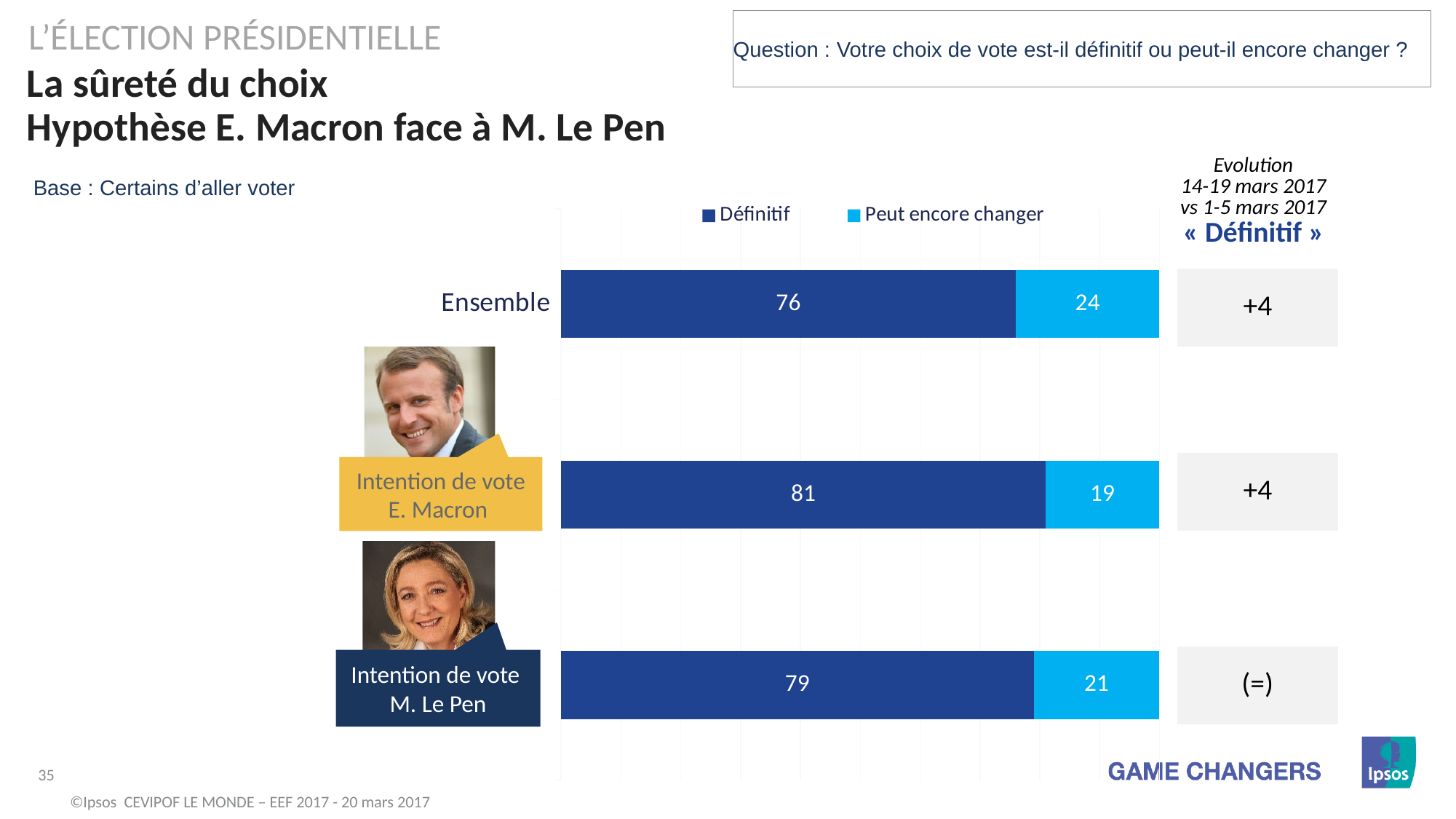
How many categories are shown in the chart? 3 Which category has the lowest 'Définitif' value? Ensemble What is the 'Définitif' value for Ensemble? 76 What kind of chart is shown on the slide? Stacked bar chart What is the 'Définitif' value for Intention de vote M. Le Pen? 79 What is the 'Peut encore changer' value for Intention de vote E. Macron? 19 What are the two series listed in the legend? Définitif and Peut encore changer Which category has the highest 'Définitif' value? Intention de vote E. Macron How many series does the legend list? 2 Which is larger: the 'Peut encore changer' value for Ensemble or for Intention de vote M. Le Pen? Ensemble What is the total of the stacked bar for Intention de vote E. Macron? 100 What is the difference between the 'Définitif' values for Intention de vote E. Macron and Intention de vote M. Le Pen? 2